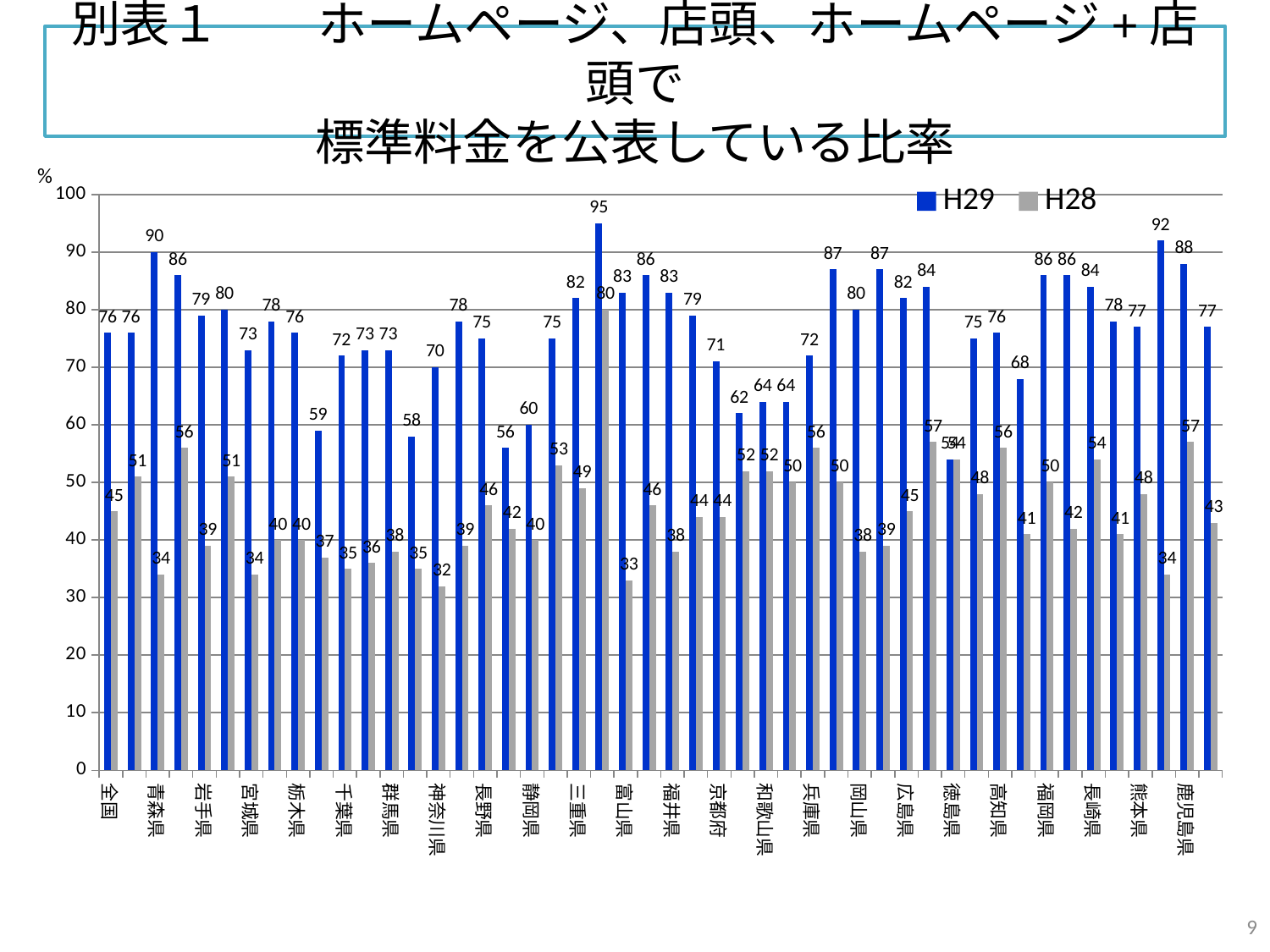
What is the highest H29 value shown in the chart? 95 What kind of chart is shown on the slide? bar chart How many series does the legend list? 2 What is the H29 value for 全国? 76 What is the difference between the H29 and H28 values for 全国? 31 What is the H29 value for 青森県? 90 What is the lowest H28 value shown in the chart? 32 What are the two series named in the legend? H29 and H28 Which has the higher H29 value, 青森県 or 岩手県? 青森県 What is the H28 value for 神奈川県? 32 What is the H28 value for 全国? 45 What is the H29 value for 京都府? 71